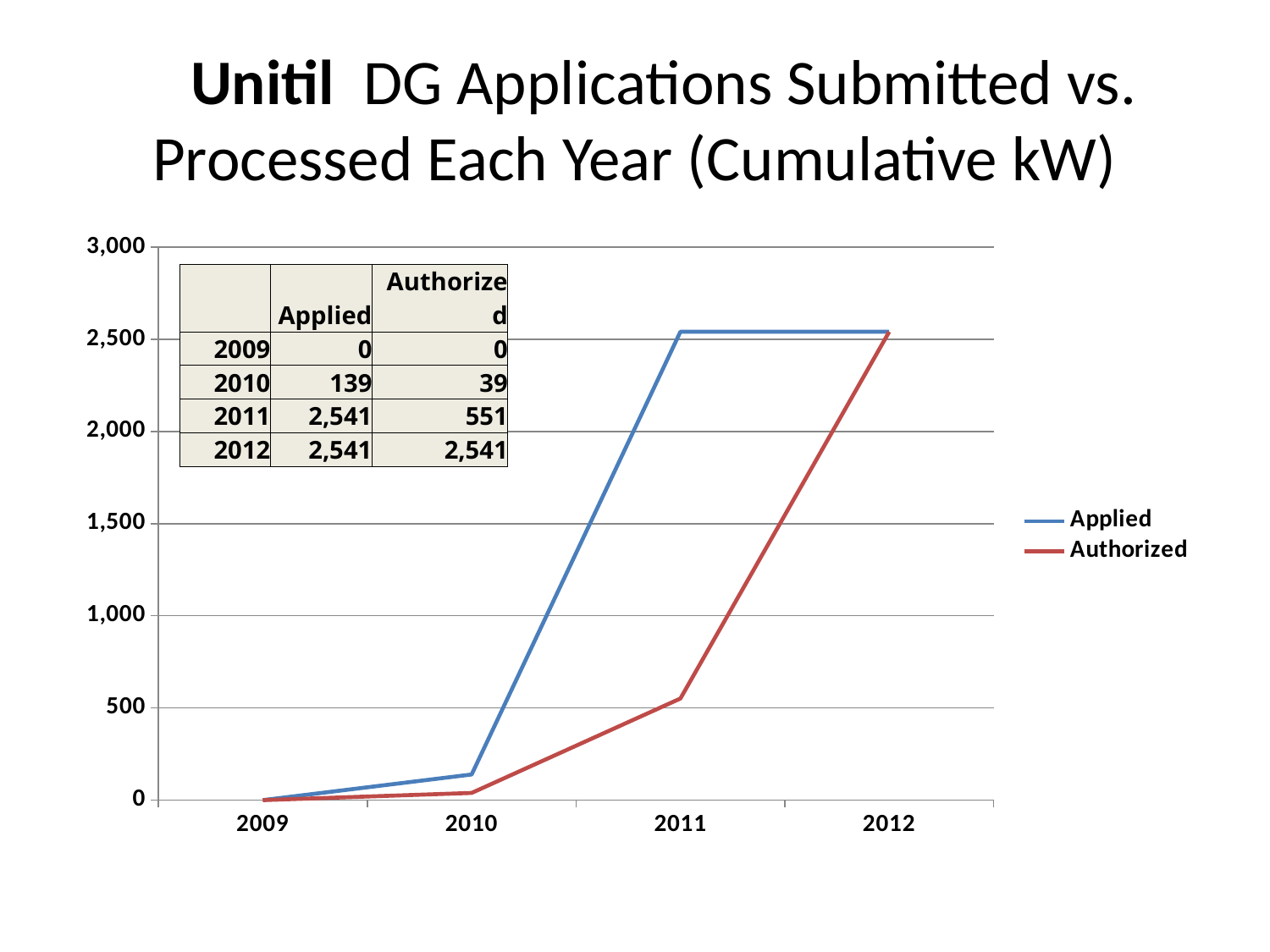
What is the Authorized value for 2011? 551 What is the Authorized value for 2010? 39 Is the Authorized value for 2011 greater or less than 1,000? less What is the difference between the Applied and Authorized values in 2011? 1,990 What kind of chart is shown on the slide? line chart What is the difference between the Applied and Authorized values in 2010? 100 Which is larger in 2011, the Applied value or the Authorized value? Applied In which year is the Authorized value lowest? 2009 How many years are shown on the x axis? 4 What is the Applied value for 2011? 2,541 How many series does the legend list? 2 What is the Applied value for 2010? 139